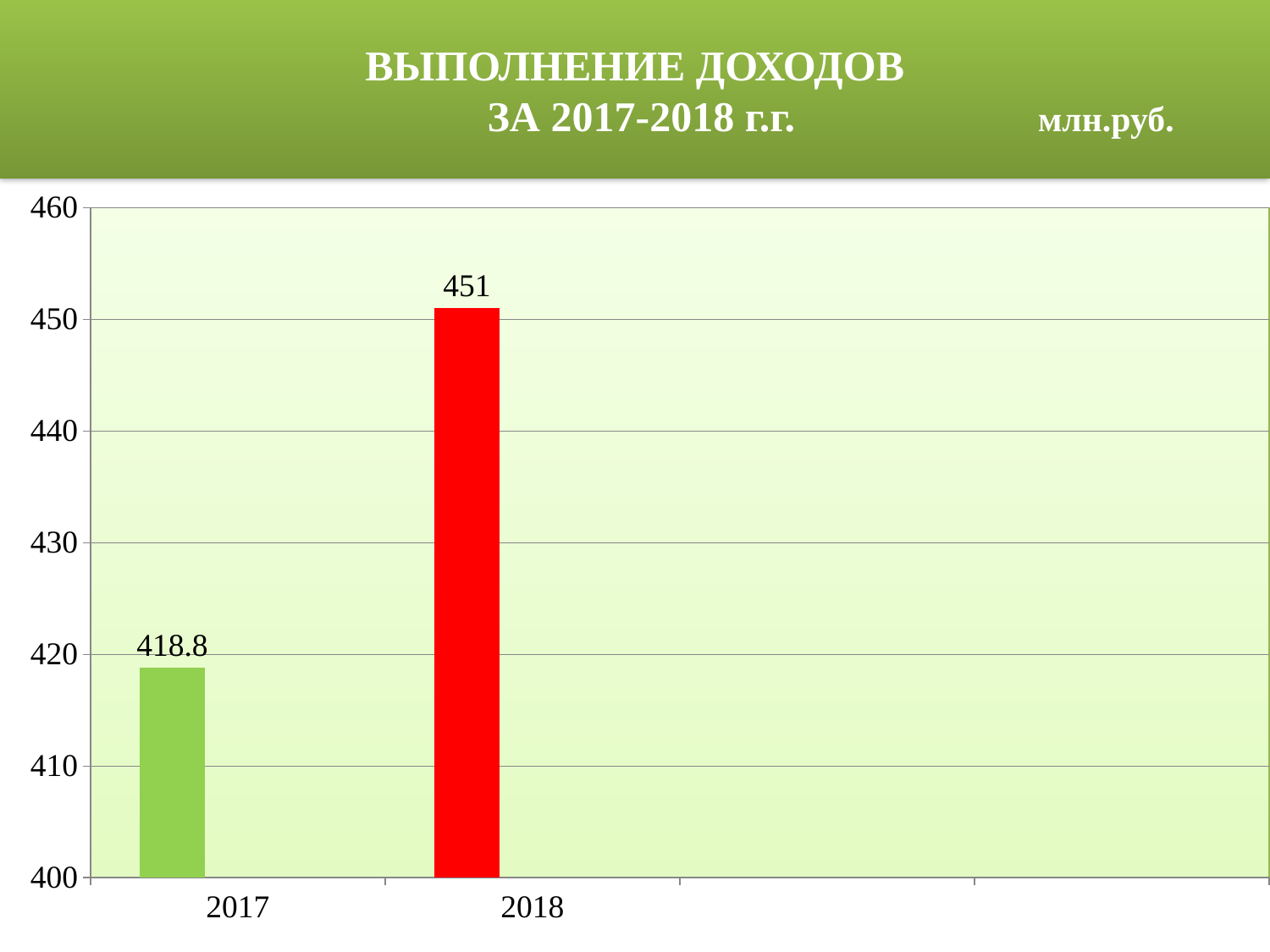
What unit is stated in the slide title? млн.руб. What is the value for 2017? 418.8 Which year has the highest value? 2018 Do the values rise or fall from 2017 to 2018? rise What is the value for 2018? 451 What kind of chart is shown on the slide? bar chart Is the value for 2017 greater or less than 420? less How many categories are shown on the x axis? 2 What is the difference between the values for 2018 and 2017? 32.2 Is the value for 2018 greater or less than 450? greater Which is larger, the value for 2017 or the value for 2018? 2018 Which year has the lowest value? 2017